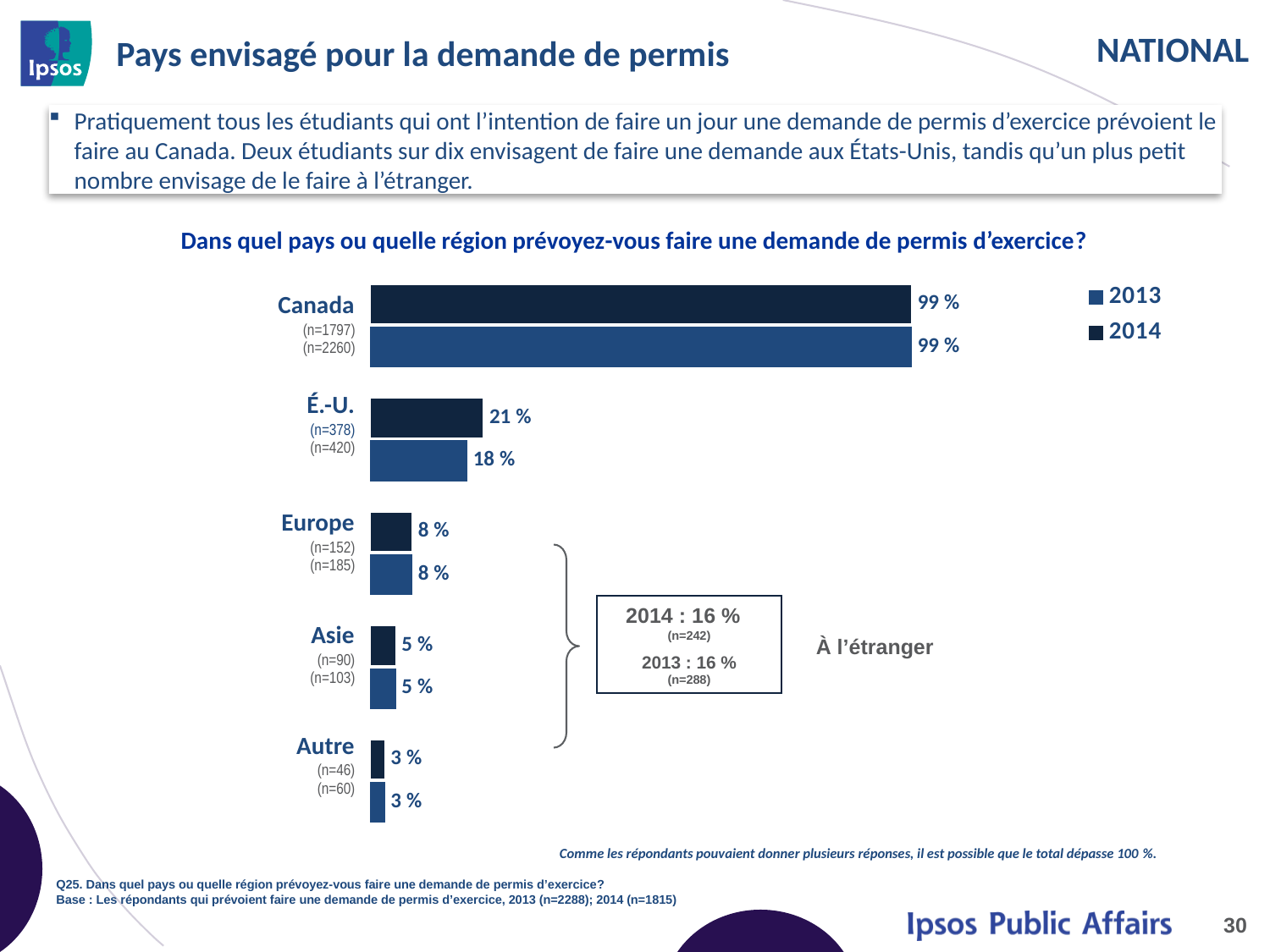
What kind of chart is shown on the slide? bar chart Which series does the legend list first? 2013 Which is larger for É.-U., the 2013 value or the 2014 value? 2013 What is the difference between the 2013 and 2014 values for É.-U.? 3 % Which country or region has the lowest value in 2014? Autre What is the value for Asie in 2014? 5 % What is the value for É.-U. in 2014? 18 % What is the value for É.-U. in 2013? 21 % What is the value for Canada in 2014? 99 % How many countries or regions are plotted in the chart? 5 How many series does the legend list? 2 Which country or region has the highest value in 2013? Canada